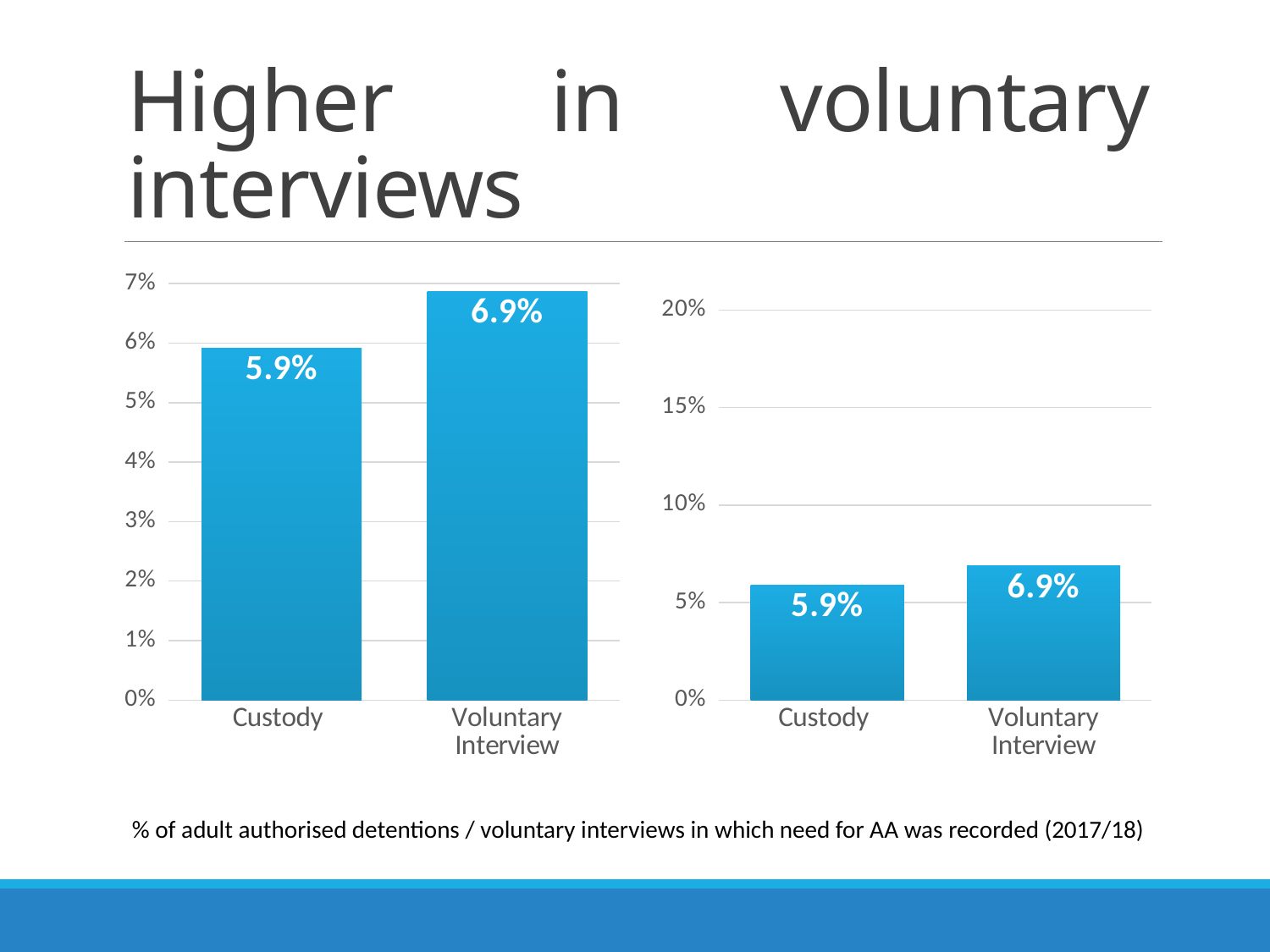
In the right chart, what is the value for Voluntary Interview? 6.9% In the right chart, is the value for Custody greater or less than 10%? less What is the highest value shown on the y axis of the right chart? 20% In the right chart, what is the value for Custody? 5.9% In the right chart, which category has the lowest value? Custody In the left chart, is the value for Voluntary Interview greater or less than 6%? greater In the left chart, what is the value for Voluntary Interview? 6.9% How many categories are shown in the left chart? 2 In the left chart, what is the difference between the Voluntary Interview and Custody values? 1.0% In the left chart, which category has the highest value? Voluntary Interview In the left chart, what is the value for Custody? 5.9% What type of chart is the right chart? bar chart